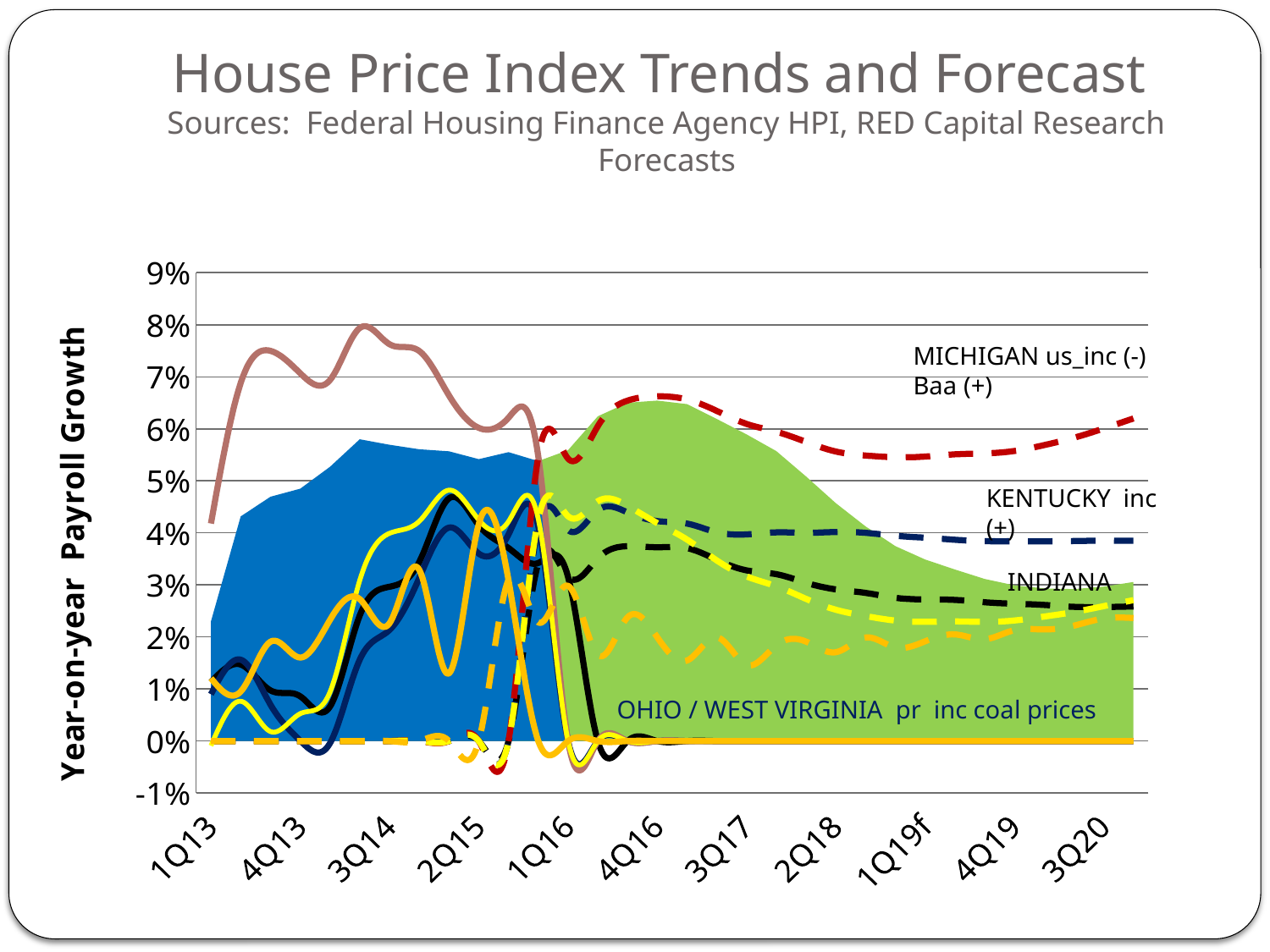
Is the value of the INDIANA dashed line at 3Q20 greater or less than 2%? greater Does the INDIANA dashed line rise or fall between 4Q16 and 3Q20? fall Is the value of the MICHIGAN dashed line at 2Q18 greater or less than 5%? greater Is the top of the green shaded area at 4Q16 greater or less than 6%? greater What is the label on the vertical axis of the chart? Year-on-year Payroll Growth Does the MICHIGAN dashed line rise or fall between 4Q16 and 2Q18? fall What kind of chart is shown on the slide? combination area and line chart What is the title of the chart on the slide? House Price Index Trends and Forecast How many period labels are shown along the x axis of the chart? 11